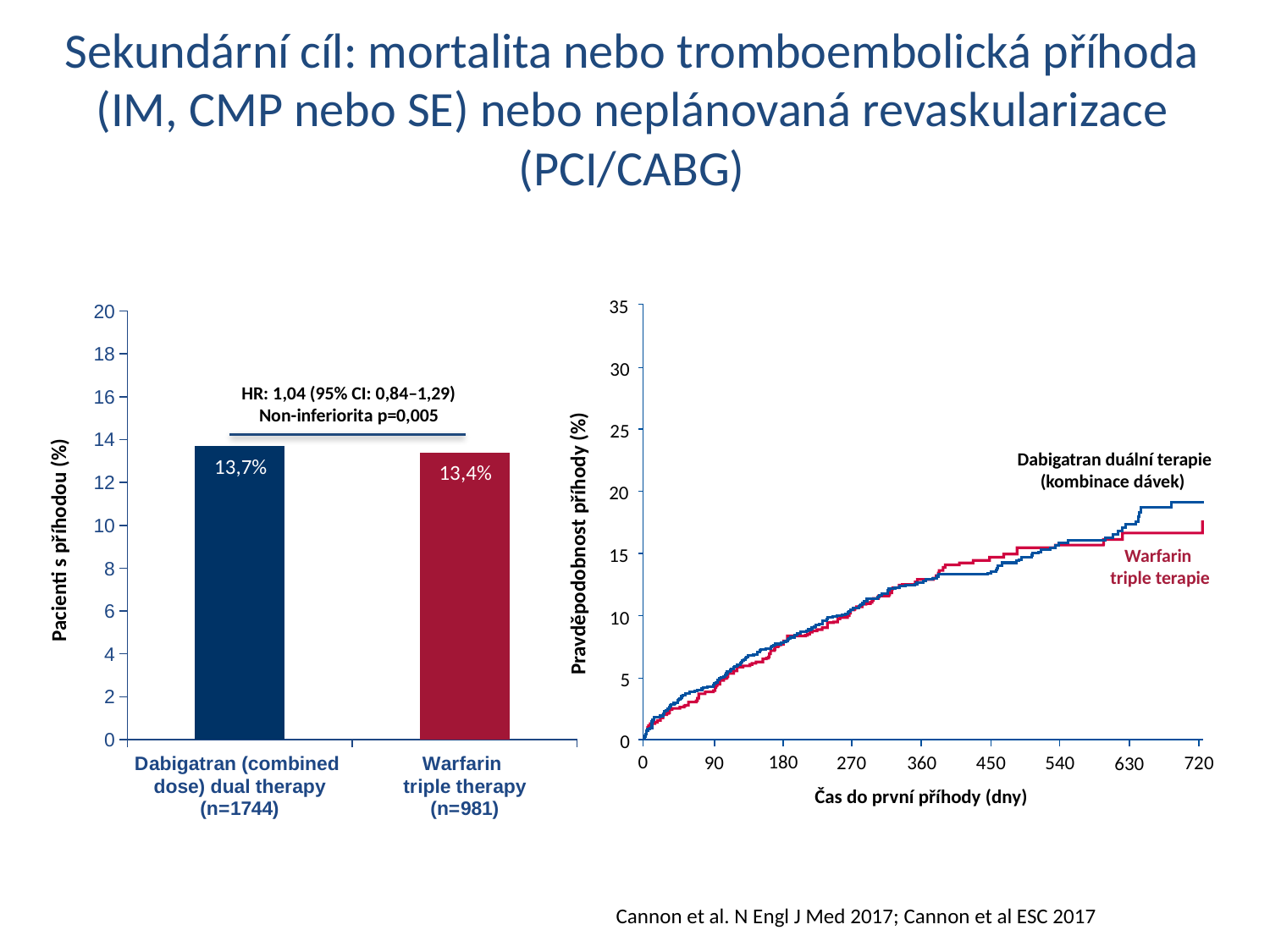
In the left bar chart, what is the value for Dabigatran (combined dose) dual therapy? 13,7% What kind of chart is the right chart on the slide? Line chart What kind of chart is the left chart on the slide? Bar chart In the left bar chart, what is the value for Warfarin triple therapy? 13,4% In the right line chart, is the value of the Dabigatran duální terapie curve at 720 days greater or less than 15? greater In the left bar chart, what is the difference between the Dabigatran dual therapy value and the Warfarin triple therapy value? 0,3 percentage points In the left bar chart, what hazard ratio is printed above the bars? HR: 1,04 (95% CI: 0,84–1,29) In the left bar chart, how many bars are plotted? 2 In the right line chart, how many series are plotted? 2 In the left bar chart, which group has the higher percentage of patients with an event? Dabigatran (combined dose) dual therapy In the right line chart, do the curves rise or fall as time to first event increases? Rise In the right line chart, what is the label of the x axis? Čas do první příhody (dny)